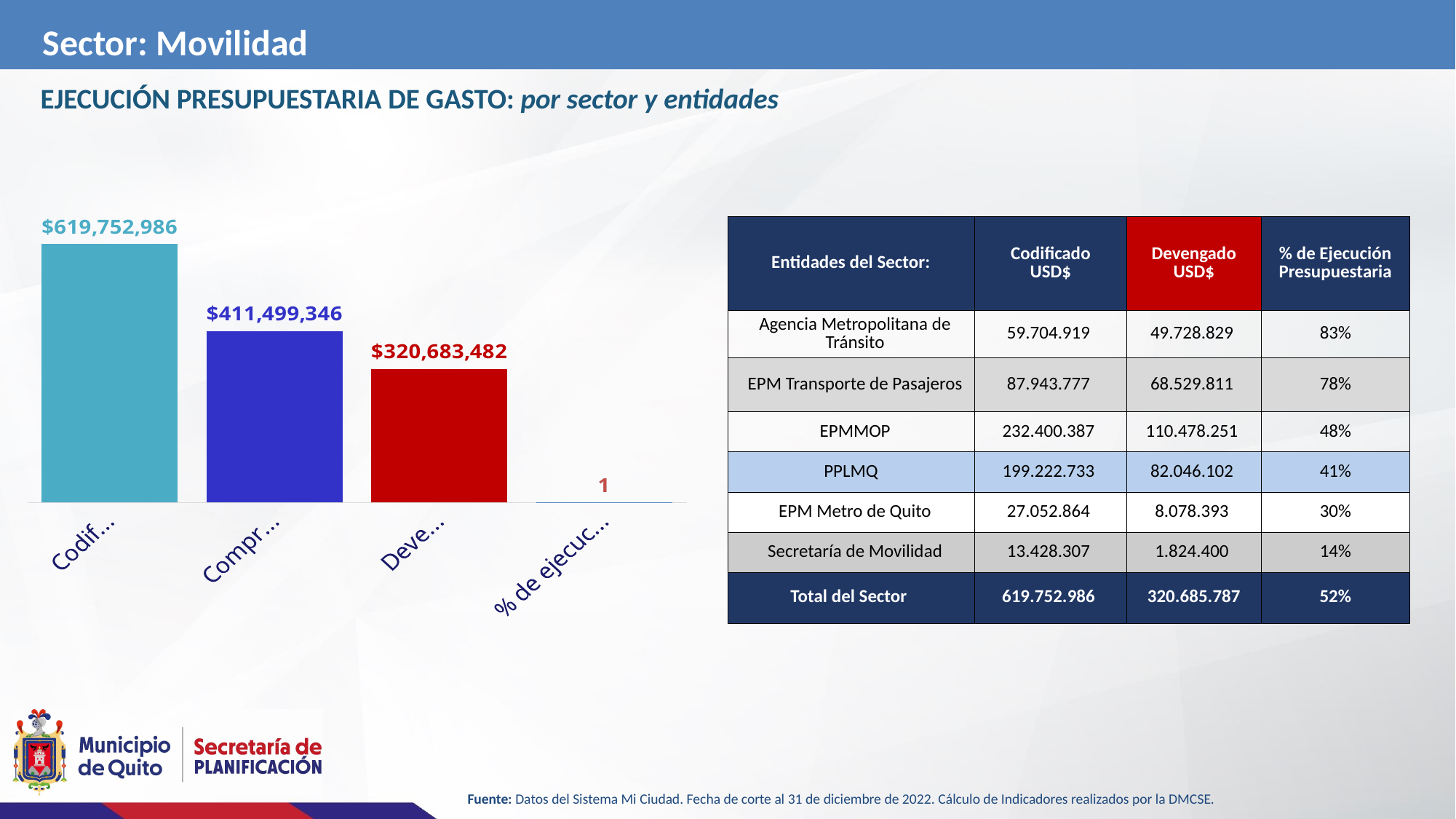
What type of chart is shown on the slide? Bar chart What is the difference between the second bar ($411,499,346) and the third bar ($320,683,482)? $90,815,864 What is the value shown on the third bar of the chart, labelled "Deve..."? $320,683,482 Which is larger, the value of the "Compr..." bar or the "Deve..." bar? Compr... What is the value shown on the first (leftmost) bar of the chart, labelled "Codif..."? $619,752,986 Which bar in the chart has the highest value? Codif... ($619,752,986) Which bar in the chart has the lowest value? % de ejecuc... (1) What is the difference between the first bar ($619,752,986) and the second bar ($411,499,346)? $208,253,640 What value is printed above the fourth bar, labelled "% de ejecuc..."? 1 Do the bar values rise or fall from left to right across the chart? Fall How many bars are plotted in the chart? 4 What is the value shown on the second bar of the chart, labelled "Compr..."? $411,499,346